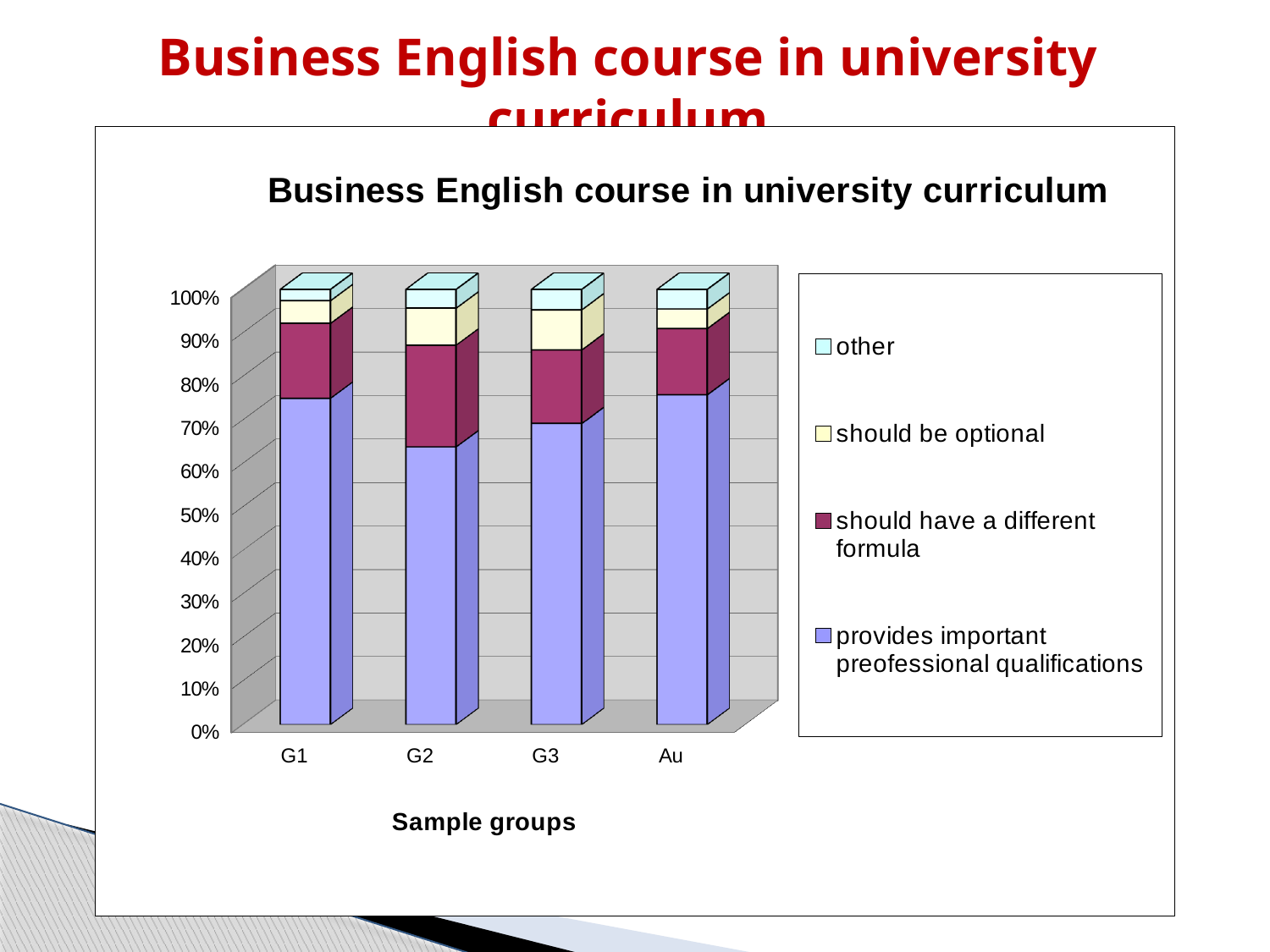
Which group has the larger share for 'should be optional', G1 or G2? G2 How many sample groups are shown on the x axis of the chart? 4 What is the title of the chart? Business English course in university curriculum Which group has the larger share for 'provides important preofessional qualifications', G1 or G2? G1 Is the share for 'provides important preofessional qualifications' in group G1 greater or less than 70%? greater Which sample group has the smallest share for 'provides important preofessional qualifications'? G2 What is the label of the x axis of the chart? Sample groups Is the share for 'provides important preofessional qualifications' in group Au greater or less than 70%? greater What kind of chart is shown on the slide? stacked bar chart Is the share for 'provides important preofessional qualifications' in group G2 greater or less than 70%? less How many series does the chart's legend list? 4 Which group has the larger share for 'should have a different formula', G2 or Au? G2